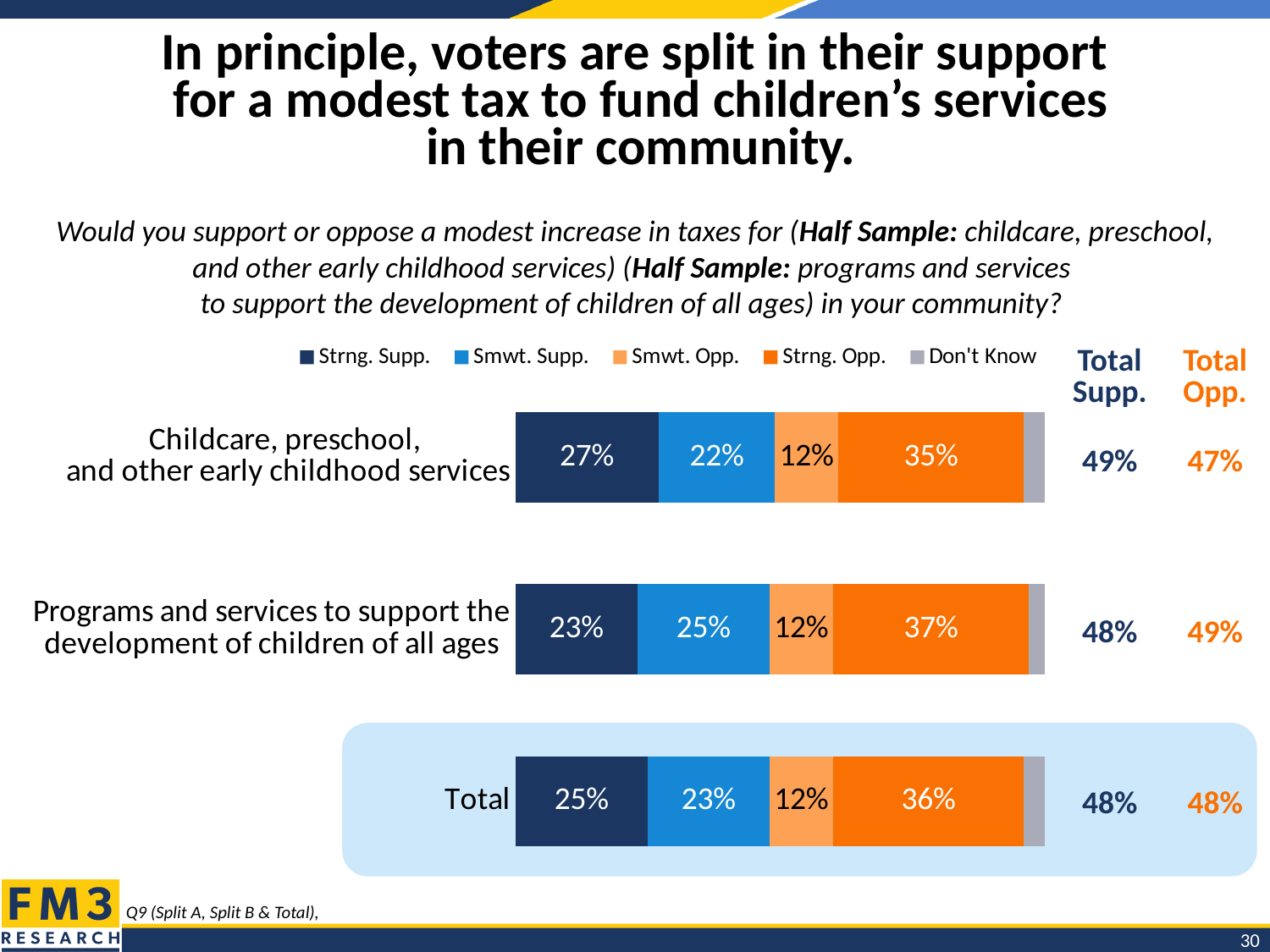
What percentage of voters strongly support a modest tax increase for childcare, preschool, and other early childhood services? 27% What kind of chart is shown on the slide? Stacked bar chart What is the Smwt. Supp. value for the Total bar? 23% Which category has the highest Strng. Opp. value? Programs and services to support the development of children of all ages What is the difference between the Strng. Opp. and Strng. Supp. values for the Total bar? 11% How many categories (bars) are shown in the chart? 3 Is the Strng. Supp. value larger for childcare, preschool, and other early childhood services or for programs and services to support the development of children of all ages? Childcare, preschool, and other early childhood services What is the Total Opp. figure shown for programs and services to support the development of children of all ages? 49% What is the Total Supp. figure shown for childcare, preschool, and other early childhood services? 49% How many series does the legend list? 5 What is the Strng. Opp. value for programs and services to support the development of children of all ages? 37% Which category has the lowest Strng. Supp. value? Programs and services to support the development of children of all ages